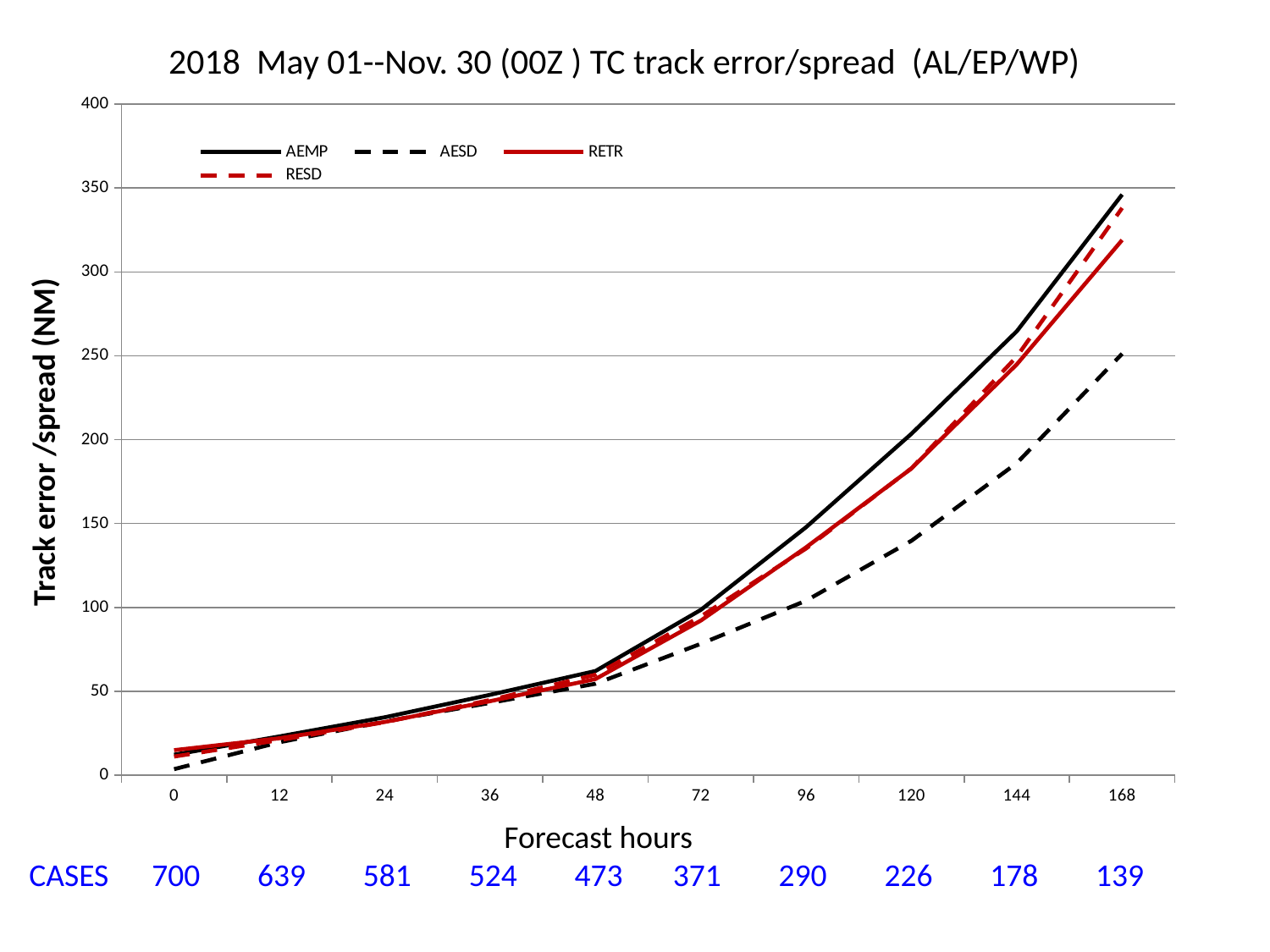
How many series does the legend list? 4 Is the AESD value at 144 forecast hours greater or less than 200? less Is the AEMP value at 168 forecast hours greater or less than 300? greater What is the label of the y axis? Track error /spread (NM) At 144 forecast hours, which is larger, AEMP or AESD? AEMP Which series has the highest value at 168 forecast hours? AEMP How many cases are listed for 168 forecast hours? 139 Is the RETR value at 120 forecast hours greater or less than 200? less Do the AEMP values rise or fall as forecast hours increase? rise How many forecast-hour points are shown along the x axis? 10 What kind of chart is shown on the slide? line chart Which series has the lowest value at 168 forecast hours? AESD